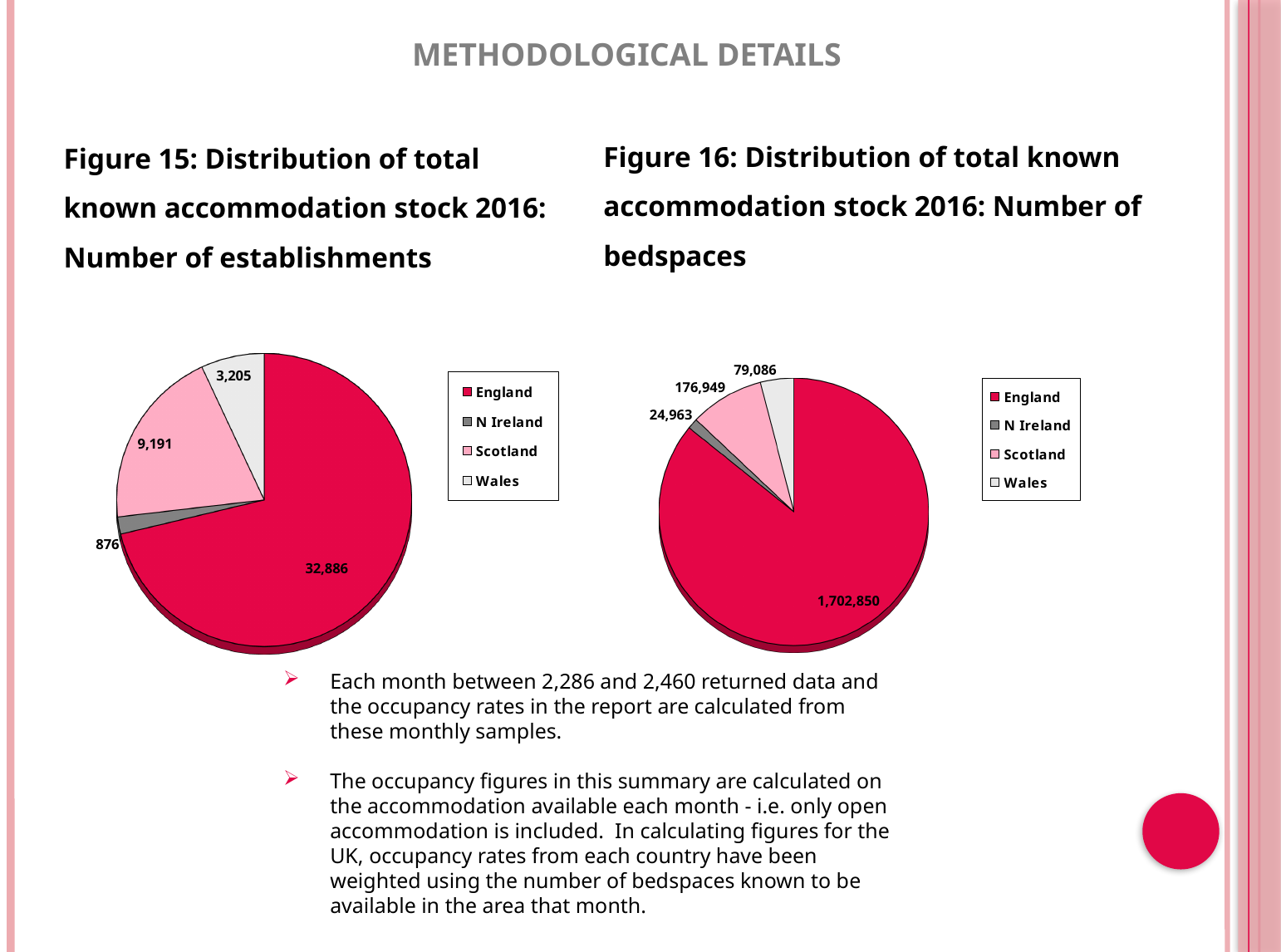
What type of chart is Figure 16? Pie chart In Figure 16 (Number of bedspaces), what is the value for Wales? 79,086 In Figure 15, which country is shown in the lightest (white/grey) colour in the legend? Wales In Figure 15 (Number of establishments), which country has the largest slice? England In Figure 15 (Number of establishments), what is the difference between the values for Scotland and Wales? 5,986 In Figure 15 (Number of establishments), what is the value for N Ireland? 876 In Figure 16 (Number of bedspaces), what is the difference between the values for Scotland and Wales? 97,863 In Figure 16 (Number of bedspaces), what is the value for England? 1,702,850 How many countries are shown in the Figure 15 pie chart? 4 In Figure 16 (Number of bedspaces), which country has the smallest slice? N Ireland In Figure 15 (Number of establishments), what is the value for Scotland? 9,191 In Figure 16 (Number of bedspaces), which is larger, the value for Scotland or the value for Wales? Scotland